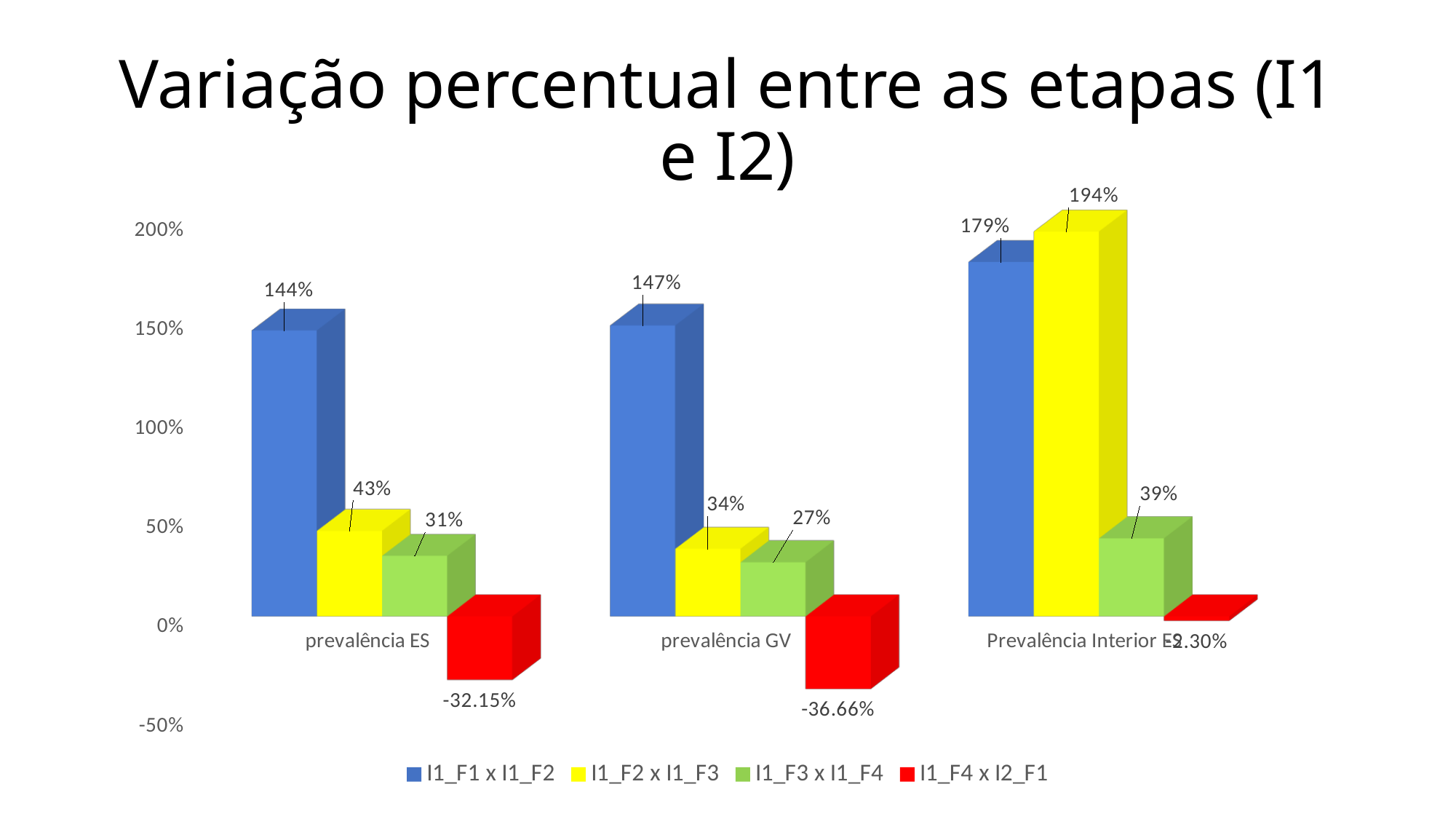
Which colour represents the I1_F4 x I2_F1 series? Red Which is larger for Prevalência Interior ES: the I1_F1 x I1_F2 value or the I1_F2 x I1_F3 value? I1_F2 x I1_F3 What is the value of the I1_F4 x I2_F1 series for prevalência GV? -36.66% What is the difference between the I1_F1 x I1_F2 values for prevalência GV and prevalência ES? 3% How many categories are shown on the x axis? 3 Which category has the highest value for the I1_F1 x I1_F2 series? Prevalência Interior ES What kind of chart is shown on the slide? Bar chart What is the value of the I1_F1 x I1_F2 series for prevalência ES? 144% Which category has the lowest value for the I1_F2 x I1_F3 series? prevalência GV What is the value of the I1_F3 x I1_F4 series for prevalência ES? 31% What is the value of the I1_F2 x I1_F3 series for Prevalência Interior ES? 194% How many series does the legend list? 4